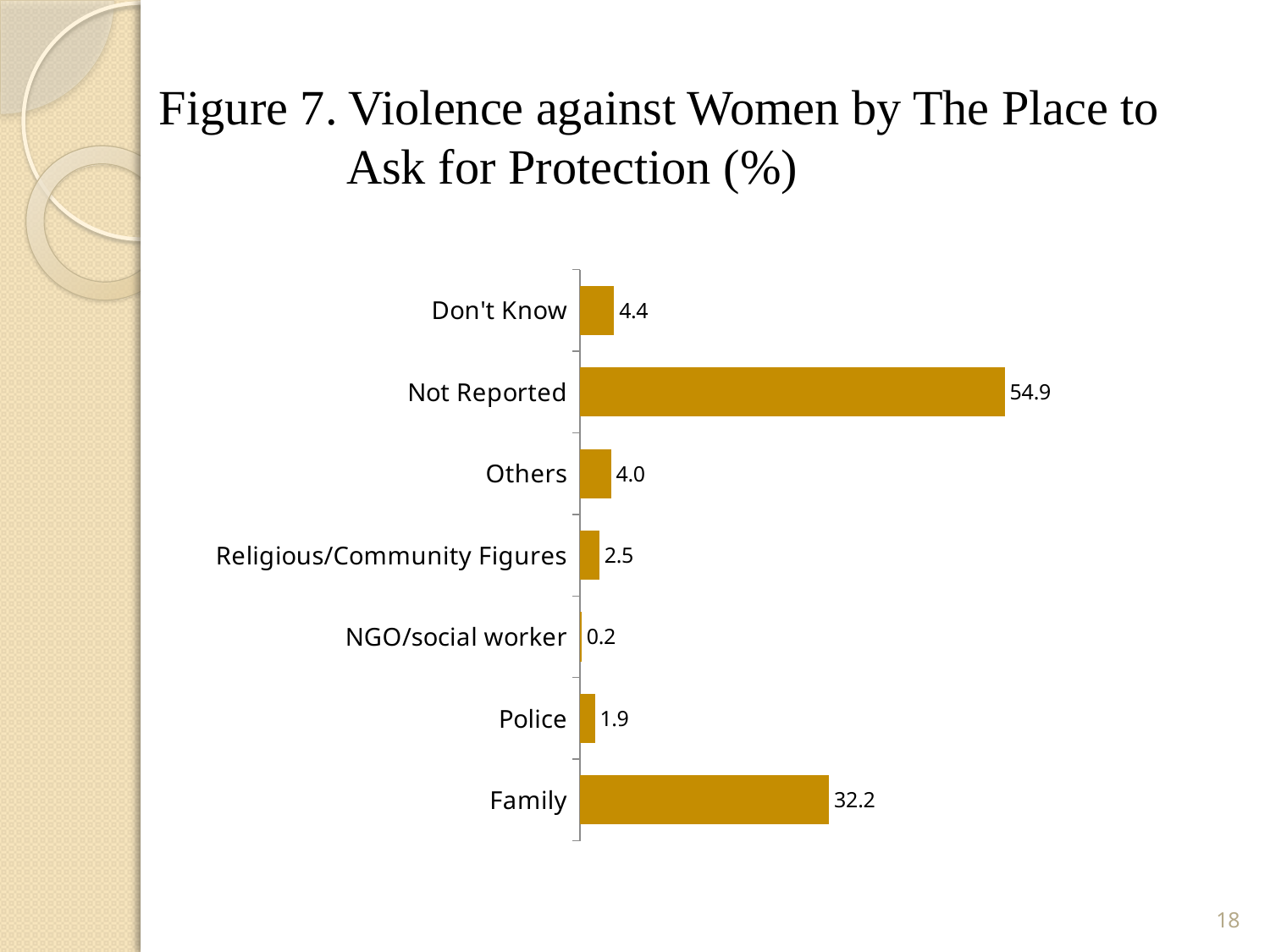
Which is larger, the value for Don't Know or the value for Others? Don't Know Which category has the highest value? Not Reported What is the value for Police? 1.9 What kind of chart is shown on the slide? Bar chart What is the value for NGO/social worker? 0.2 What is the value for Religious/Community Figures? 2.5 How many categories are shown in the chart? 7 What is the title of the chart? Figure 7. Violence against Women by The Place to Ask for Protection (%) What is the value for Family? 32.2 What is the value for Not Reported? 54.9 Which category has the lowest value? NGO/social worker What is the difference between the values for Not Reported and Family? 22.7